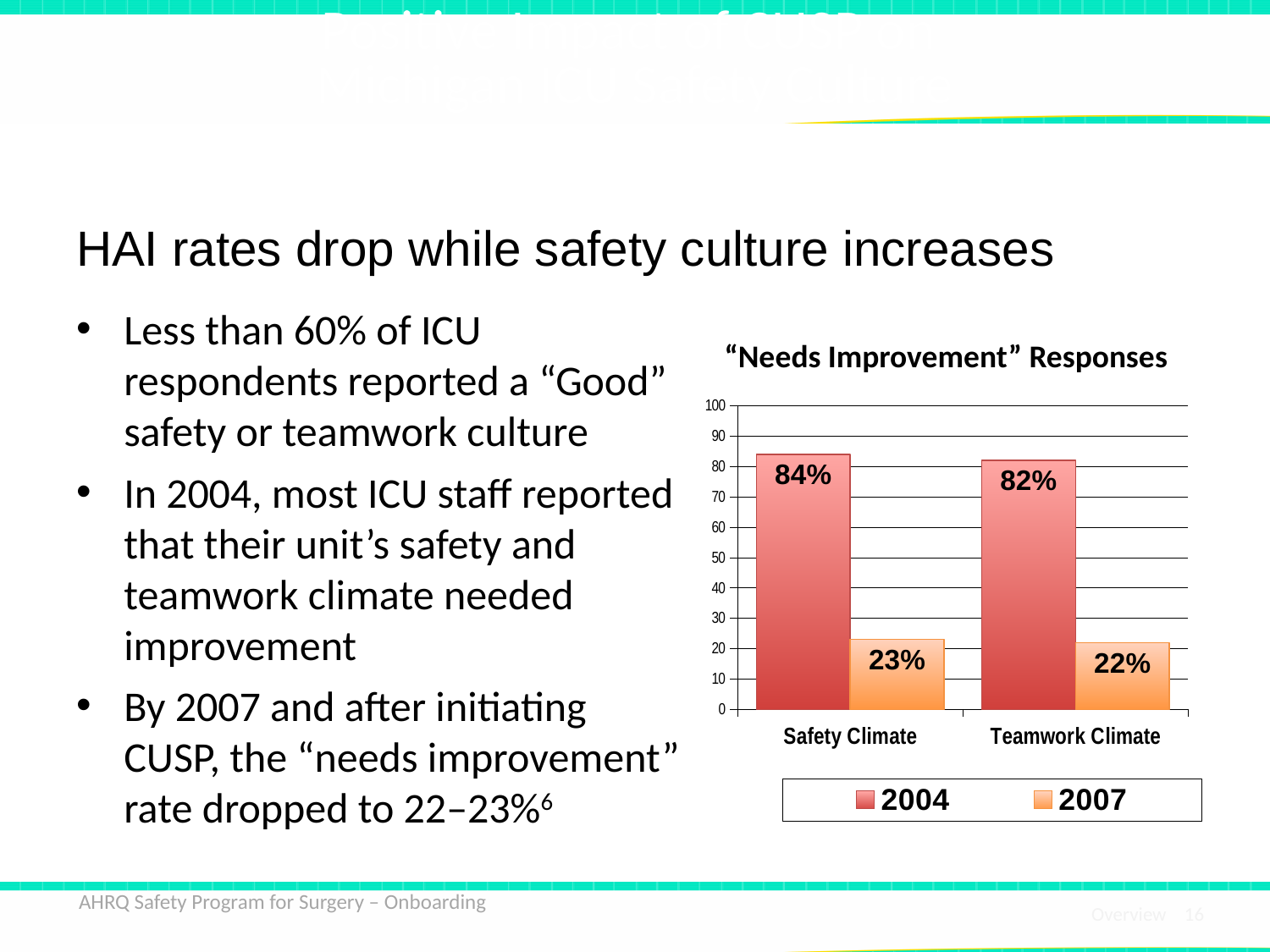
What is the 2004 value for Safety Climate? 84% Which category has the highest 2004 value? Safety Climate What is the 2007 value for Safety Climate? 23% What is the title of the chart? "Needs Improvement" Responses How many categories are shown on the x axis? 2 What kind of chart is shown? bar chart How many series does the legend list? 2 What is the difference between the 2004 and 2007 values for Safety Climate? 61% What is the 2007 value for Teamwork Climate? 22% Which is larger: the 2004 value for Teamwork Climate or the 2007 value for Teamwork Climate? 2004 What is the 2004 value for Teamwork Climate? 82% Which category has the lowest 2007 value? Teamwork Climate